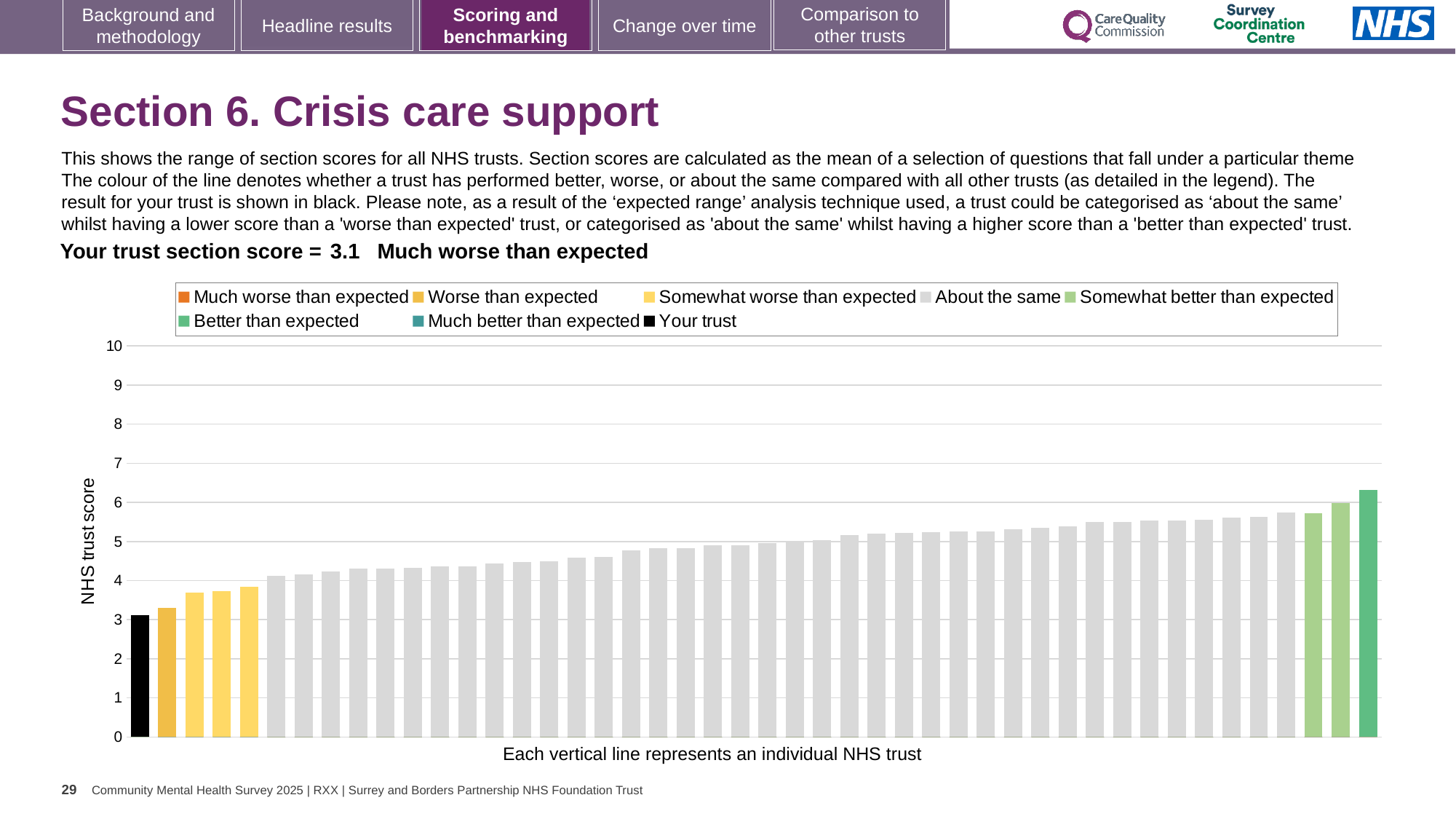
Is the value of the black 'Your trust' bar greater or less than 4? less What is the section score for your trust shown on the slide? 3.1 What kind of chart is used to show the NHS trust scores? bar chart Which legend category does the highest bar in the chart belong to? Better than expected How many bars in the chart are shown in green shades? 3 How many bars in the chart are shown in yellow shades? 4 How many entries does the chart legend list? 8 Is the value of the tallest bar in the chart greater or less than 6? greater Which performance category is your trust placed in for this section? Much worse than expected Which legend category does the lowest bar in the chart belong to? Your trust Do the bar values rise or fall from left to right across the chart? rise What is the label on the vertical axis of the chart? NHS trust score